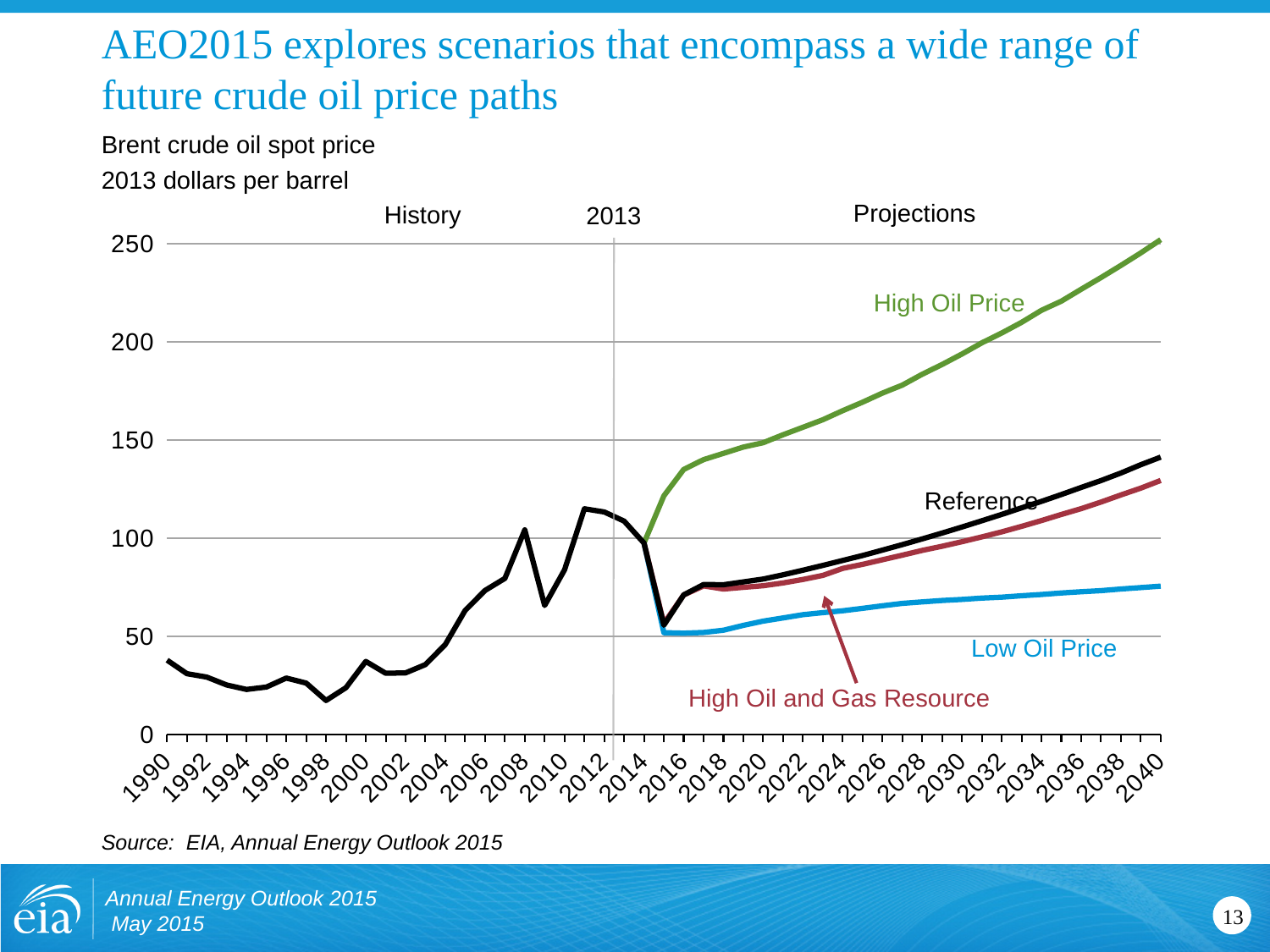
Is the historical value in 1998 greater or less than 50? less Which scenario has the highest Brent crude oil spot price in 2040? High Oil Price Which scenario has the lowest Brent crude oil spot price in 2040? Low Oil Price Does the High Oil Price line rise or fall between 2014 and 2040? rise Which year marks the boundary between History and Projections on the chart? 2013 Is the Low Oil Price value in 2040 greater or less than 100? less Is the Reference value in 2040 greater or less than 100? greater In what units is the Brent crude oil spot price expressed on the chart? 2013 dollars per barrel How many projection scenarios are labeled on the chart? 4 In 2040, which is higher: the Reference scenario or the High Oil and Gas Resource scenario? Reference What kind of chart is shown on the slide? line chart